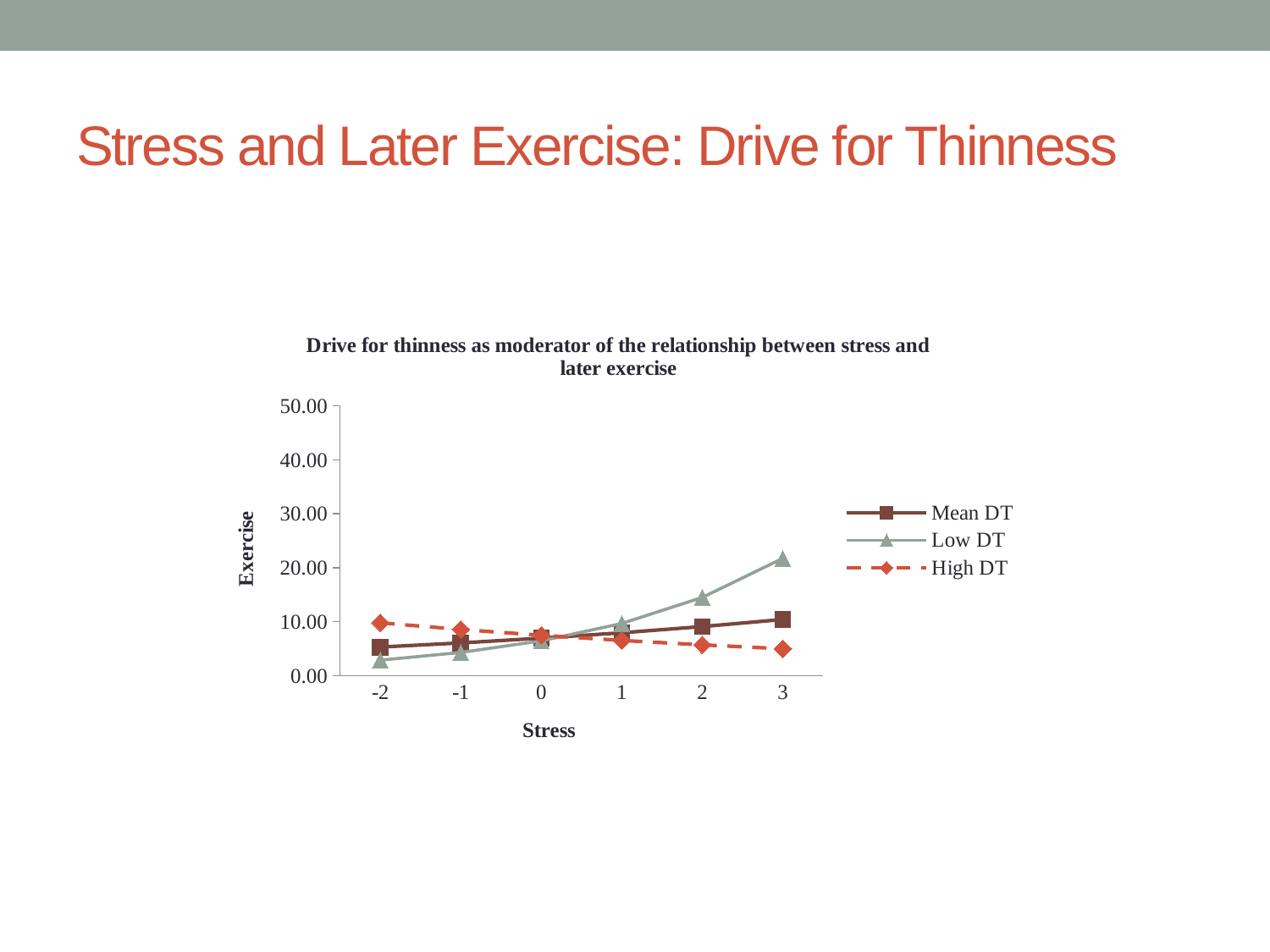
How many Stress values are plotted along the x axis? 6 Which series has the lowest Exercise value at Stress -2? Low DT Is the Low DT value at Stress 3 greater or less than 20.00? greater What kind of chart is shown on the slide? Line chart What is the label of the y axis? Exercise Is the High DT value at Stress 3 greater or less than 10.00? less At Stress -2, which is larger: High DT or Low DT? High DT Does the Low DT line rise or fall as Stress increases from -2 to 3? Rises How many series does the legend list? 3 Does the High DT line rise or fall as Stress increases from -2 to 3? Falls Which series has the highest Exercise value at Stress 3? Low DT At Stress 3, which is larger: Low DT or High DT? Low DT